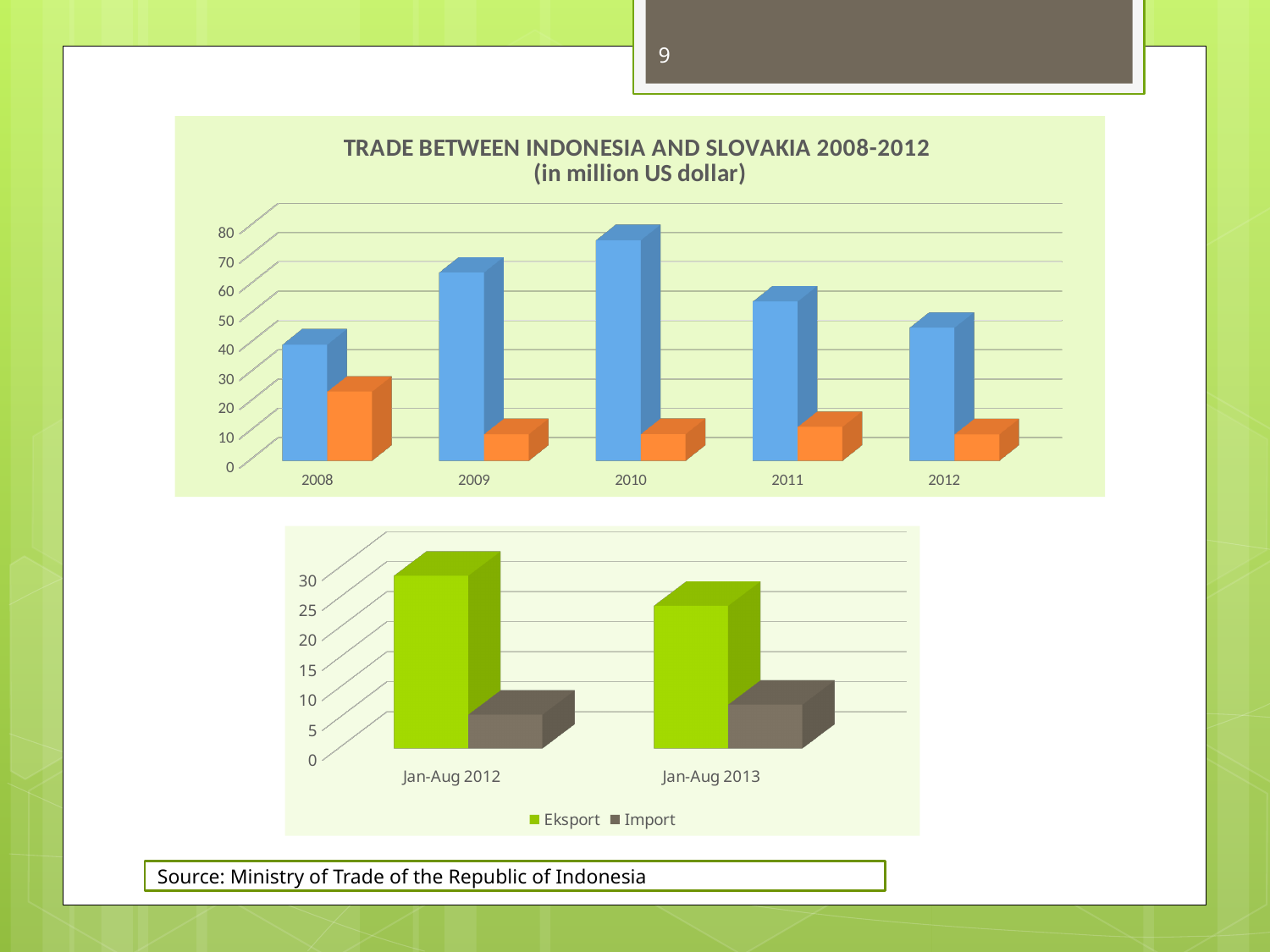
In the top chart (Trade between Indonesia and Slovakia), which year has the tallest blue bar? 2010 In the top chart (Trade between Indonesia and Slovakia), which year has the tallest orange bar? 2008 What kind of chart is the top chart titled 'TRADE BETWEEN INDONESIA AND SLOVAKIA 2008-2012'? Bar chart In the top chart (Trade between Indonesia and Slovakia), which blue bar is taller, 2009 or 2011? 2009 In the top chart (Trade between Indonesia and Slovakia), which year has the shortest blue bar? 2008 In the top chart (Trade between Indonesia and Slovakia), how many years are shown on the x axis? 5 In the bottom chart (Jan-Aug 2012 vs Jan-Aug 2013), how many series does the legend list? 2 In the top chart (Trade between Indonesia and Slovakia), is the blue bar for 2008 greater or less than 50? less In the bottom chart (Jan-Aug 2012 vs Jan-Aug 2013), which period has the larger Eksport value? Jan-Aug 2012 In the bottom chart (Jan-Aug 2012 vs Jan-Aug 2013), is the Eksport value for Jan-Aug 2013 greater or less than 30? less In the top chart (Trade between Indonesia and Slovakia), is the blue bar for 2010 greater or less than 70? greater